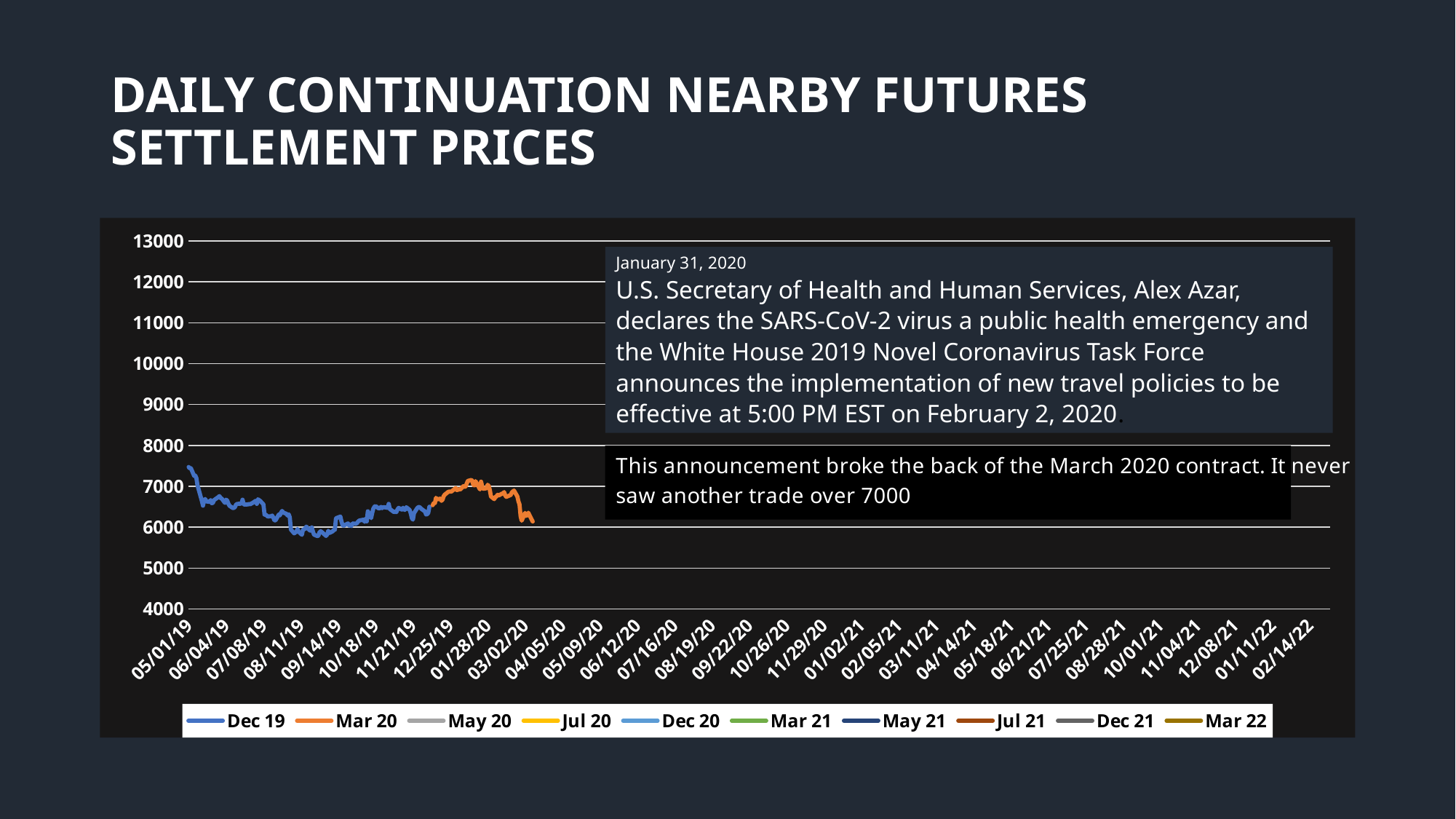
What kind of chart is shown on the slide? line chart How many series does the legend list? 10 What is the highest value shown on the y axis? 13000 How many date labels are shown on the x axis? 31 Which colour is used for the Dec 19 series? blue Which is larger: the Dec 19 value at 05/01/19 or the Mar 20 value at 03/02/20? Dec 19 value at 05/01/19 Does the Dec 19 series rise or fall between 05/01/19 and 09/14/19? fall What is the title of the chart on the slide? Daily Continuation Nearby Futures Settlement Prices Is the value of the Dec 19 series at 05/01/19 greater or less than 7000? greater Is the lowest value of the Dec 19 series, around 09/14/19, greater or less than 6000? less Is the value of the Mar 20 series at 03/02/20 greater or less than 7000? less Does the Mar 20 series rise or fall between 01/28/20 and 03/02/20? fall